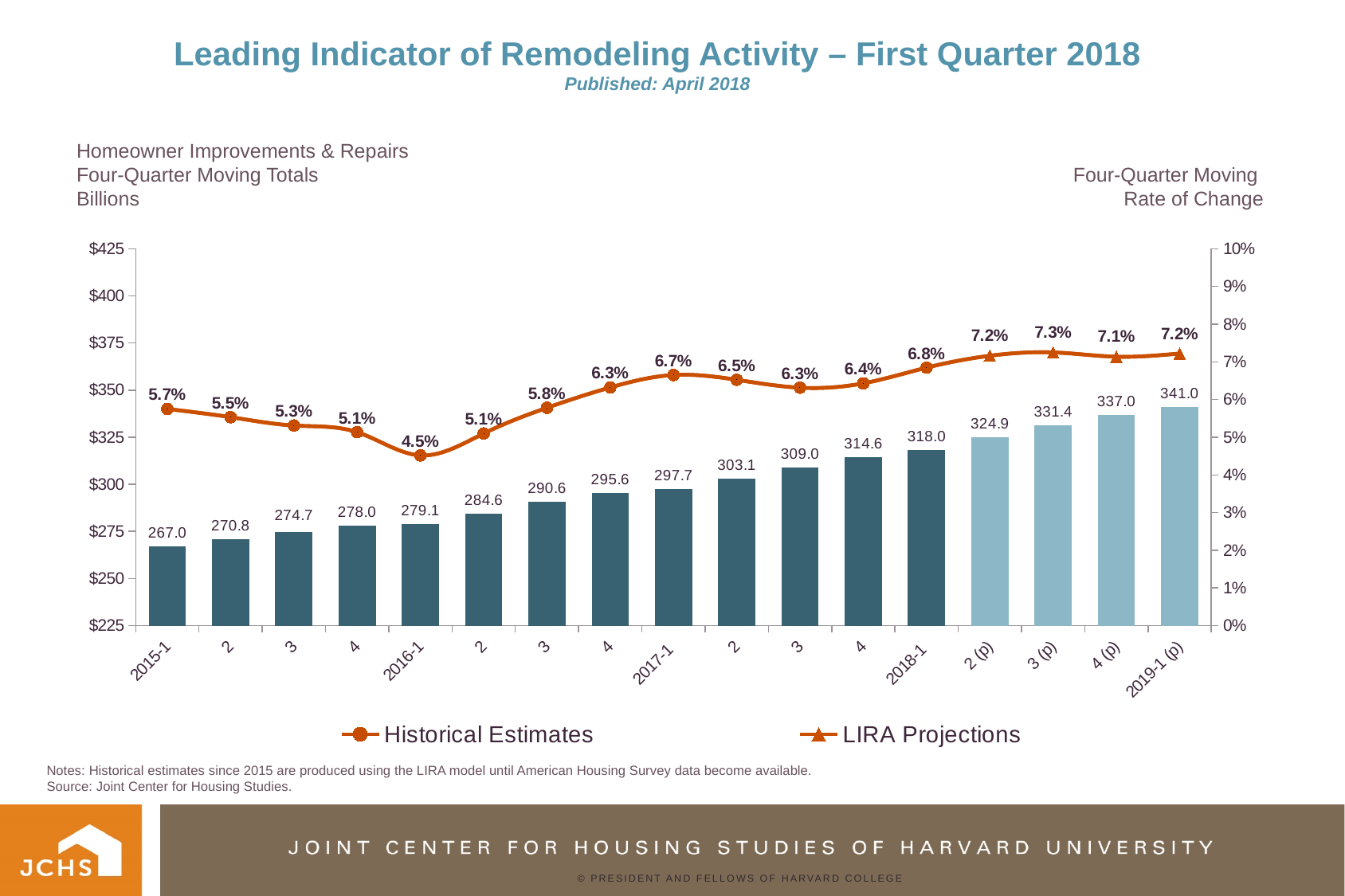
Which quarter has the highest four-quarter moving rate of change? 3 (p) (2018) What is the four-quarter moving rate of change for 2016-1? 4.5% What are the two series named in the legend? Historical Estimates and LIRA Projections What is the difference between the four-quarter moving totals for 2019-1 (p) and 2015-1? 74.0 Do the four-quarter moving totals rise or fall from 2015-1 to 2019-1 (p)? rise How many series does the legend list? 2 Which quarter has the lowest four-quarter moving total? 2015-1 What is the four-quarter moving total (in billions) for 2018-1? 318.0 How many quarters are shown on the x axis? 17 What is the projected four-quarter moving total for 2019-1 (p)? 341.0 Which is larger, the rate of change for 2017-1 or for 2017-2? 2017-1 Which quarter has the lowest four-quarter moving rate of change? 2016-1